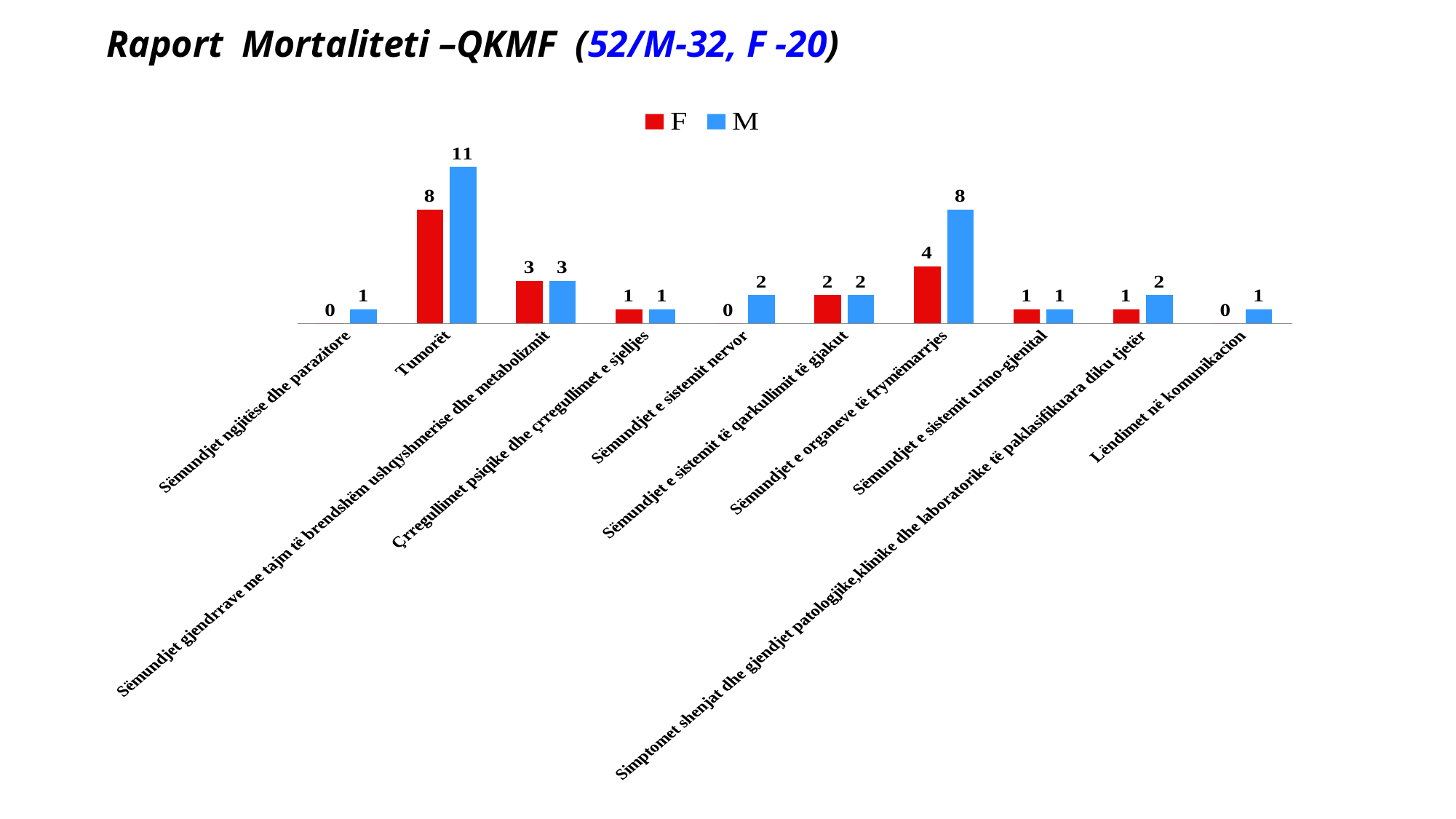
Which category has the highest M value? Tumorët Which is larger for Sëmundjet e organeve të frymëmarrjes, the F value or the M value? M How many categories are shown on the x axis? 10 What kind of chart is shown on the slide? Bar chart Which category has the highest F value? Tumorët What is the M value for Tumorët? 11 Which colour represents the F series in the legend? Red What is the difference between the M and F values for Tumorët? 3 How many series does the legend list? 2 What is the M value for Sëmundjet e sistemit nervor? 2 What is the F value for Sëmundjet e organeve të frymëmarrjes? 4 What is the difference between the M and F values for Sëmundjet e organeve të frymëmarrjes? 4